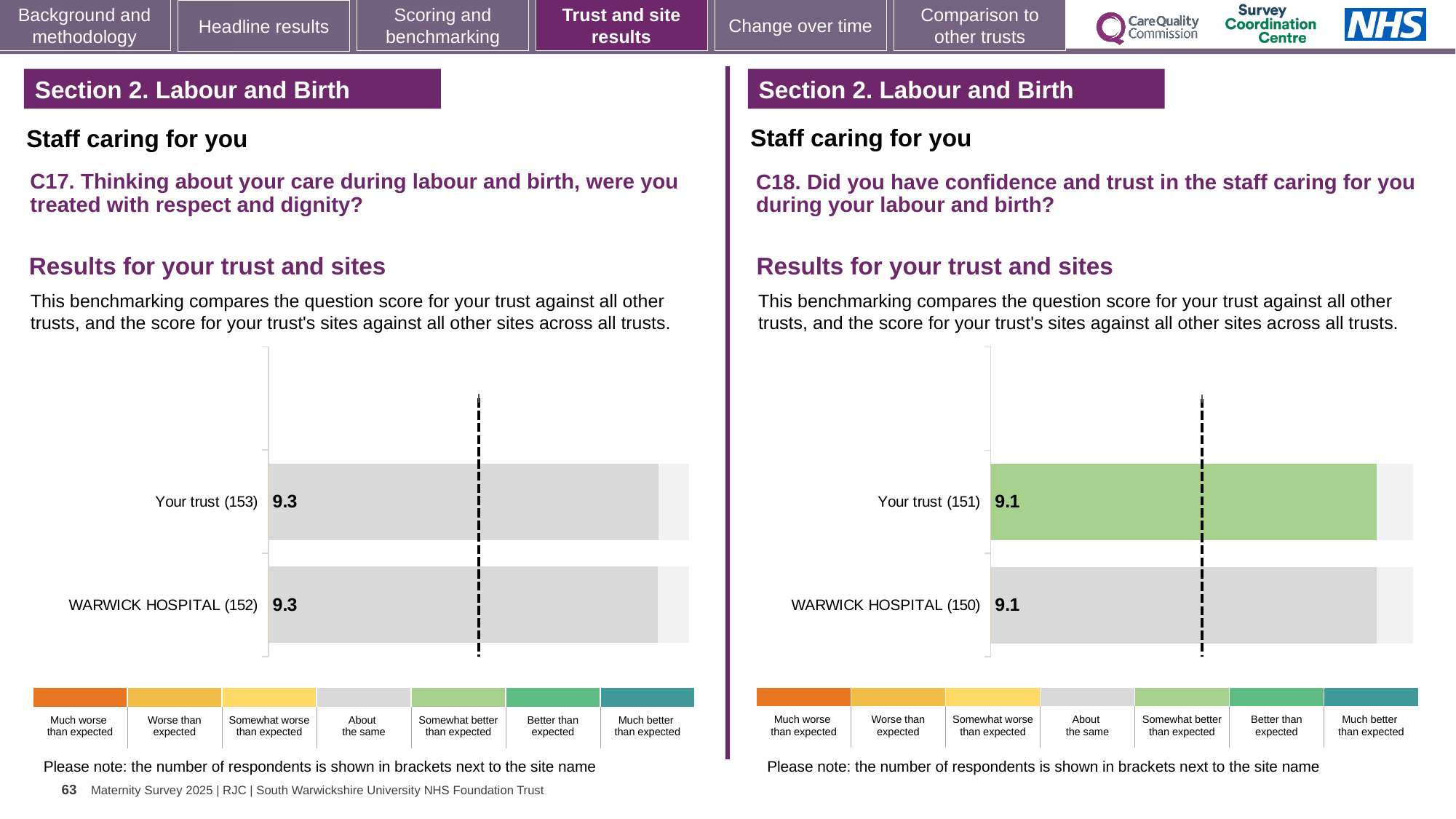
In the C18 chart on the right, what is the score for WARWICK HOSPITAL (150)? 9.1 How many bars are plotted in the C17 chart on the left? 2 What type of chart is used for the C17 results on the left? Bar chart In the C17 chart on the left, what is the score for Your trust (153)? 9.3 How many respondents are shown in brackets for WARWICK HOSPITAL in the C18 chart on the right? 150 In the C18 chart on the right, what is the difference between the Your trust score and the WARWICK HOSPITAL score? 0.0 In the C18 chart on the right, which benchmark category does the green colour of the Your trust bar represent according to the key? Somewhat better than expected In the C17 chart on the left, what is the score for WARWICK HOSPITAL (152)? 9.3 In the C18 chart on the right, what is the score for Your trust (151)? 9.1 In the C17 chart on the left, which benchmark category does the grey colour of the bars represent according to the key? About the same In the C17 chart on the left, what is the difference between the Your trust score and the WARWICK HOSPITAL score? 0.0 How many bars are plotted in the C18 chart on the right? 2